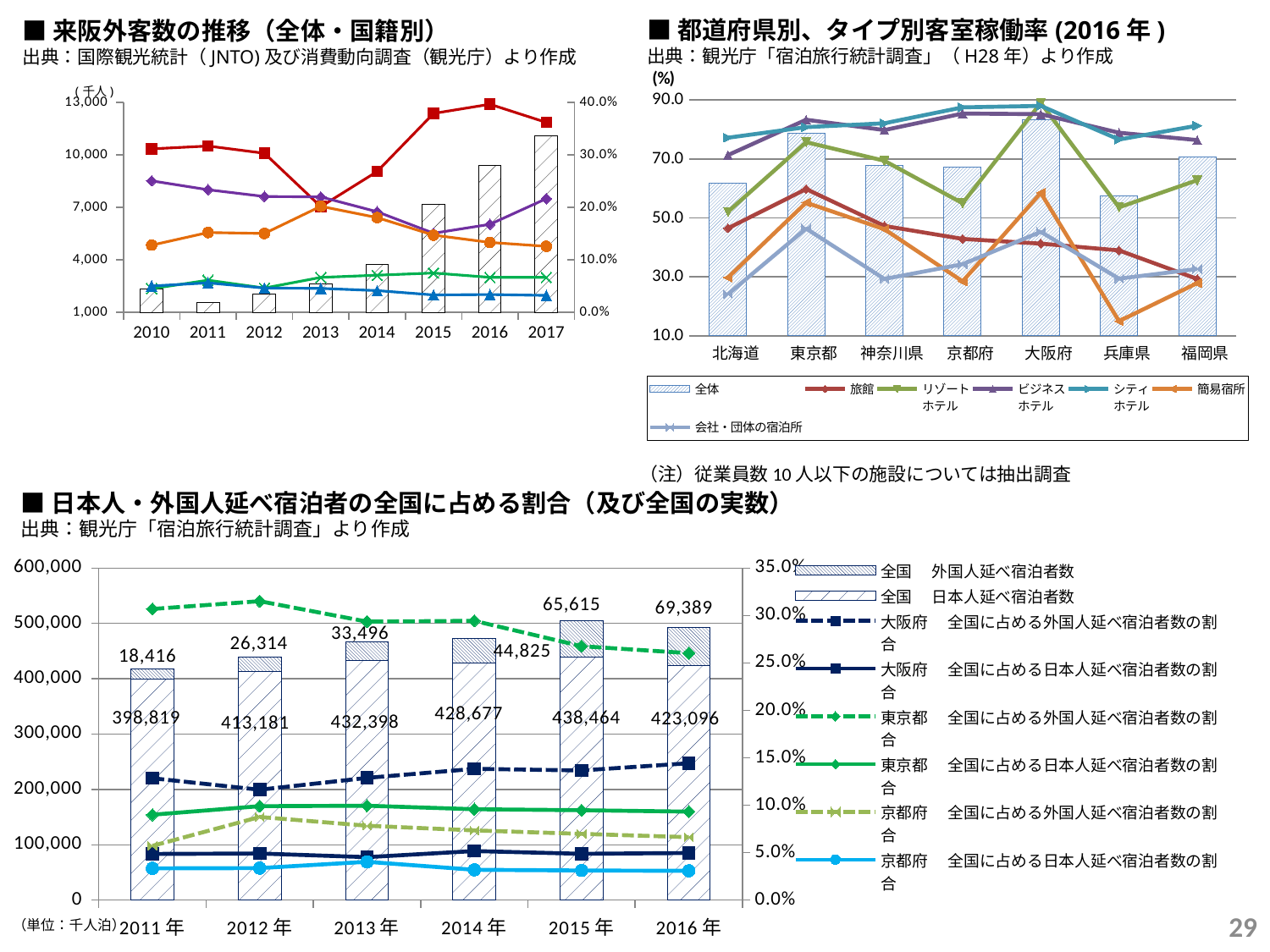
In the bottom chart (日本人・外国人延べ宿泊者の全国に占める割合), what is the value of 全国 日本人延べ宿泊者数 for 2013年? 432,398 In the bottom chart (日本人・外国人延べ宿泊者の全国に占める割合), what is the value of 全国 外国人延べ宿泊者数 for 2016年? 69,389 In the bottom chart (日本人・外国人延べ宿泊者の全国に占める割合), which is larger: 全国 日本人延べ宿泊者数 for 2014年 or for 2015年? 2015年 In the bottom chart (日本人・外国人延べ宿泊者の全国に占める割合), which year has the highest 全国 日本人延べ宿泊者数? 2015年 In the bottom chart (日本人・外国人延べ宿泊者の全国に占める割合), what is the difference between the 全国 外国人延べ宿泊者数 values for 2016年 and 2011年? 50,973 In the bottom chart (日本人・外国人延べ宿泊者の全国に占める割合), how many series does the legend list? 8 In the top-right chart (都道府県別、タイプ別客室稼働率), how many prefectures are shown on the x axis? 7 In the bottom chart (日本人・外国人延べ宿泊者の全国に占める割合), what is the total of the stacked bar for 2015年? 504,079 In the top-right chart (都道府県別、タイプ別客室稼働率), is the 全体 value for 東京都 greater or less than 70.0? greater In the top-left chart (来阪外客数の推移), how many years are shown on the x axis? 8 In the bottom chart (日本人・外国人延べ宿泊者の全国に占める割合), which year has the lowest 全国 外国人延べ宿泊者数? 2011年 In the bottom chart (日本人・外国人延べ宿泊者の全国に占める割合), do the 全国 外国人延べ宿泊者数 values rise or fall from 2011年 to 2016年? rise